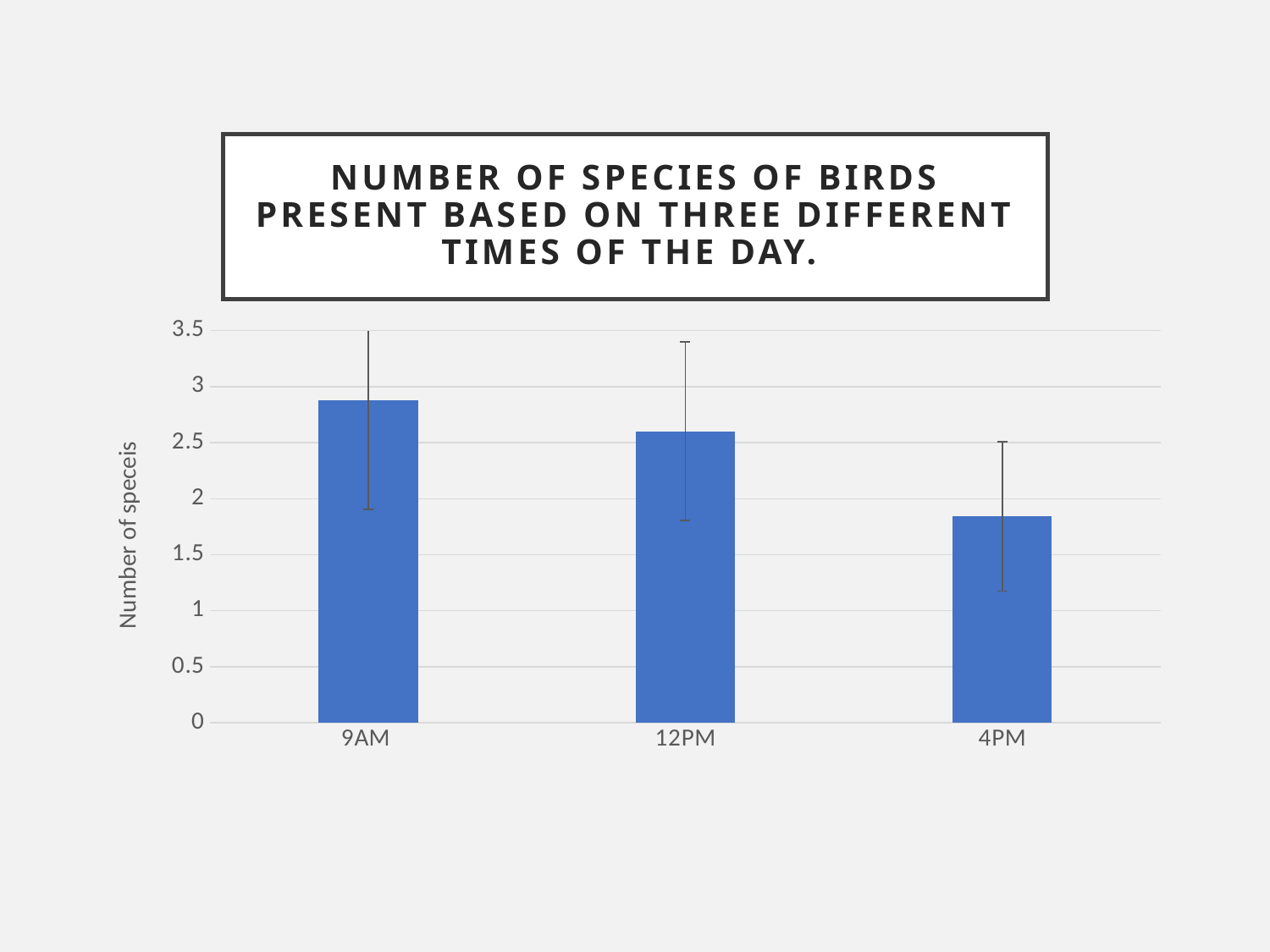
Which has a higher number of species, 9AM or 12PM? 9AM Which time of day has the lowest number of species? 4PM Is the value for 12PM greater or less than 3? less Do the values rise or fall from 9AM to 4PM along the x axis? Fall What is the label on the vertical axis of the chart? Number of speceis Is the value for 9AM greater or less than 2.5? greater Is the value for 4PM greater or less than 2? less Which time of day has the highest number of species? 9AM How many times of day are plotted on the chart? 3 What kind of chart is shown on the slide? Bar chart Which has a higher number of species, 12PM or 4PM? 12PM